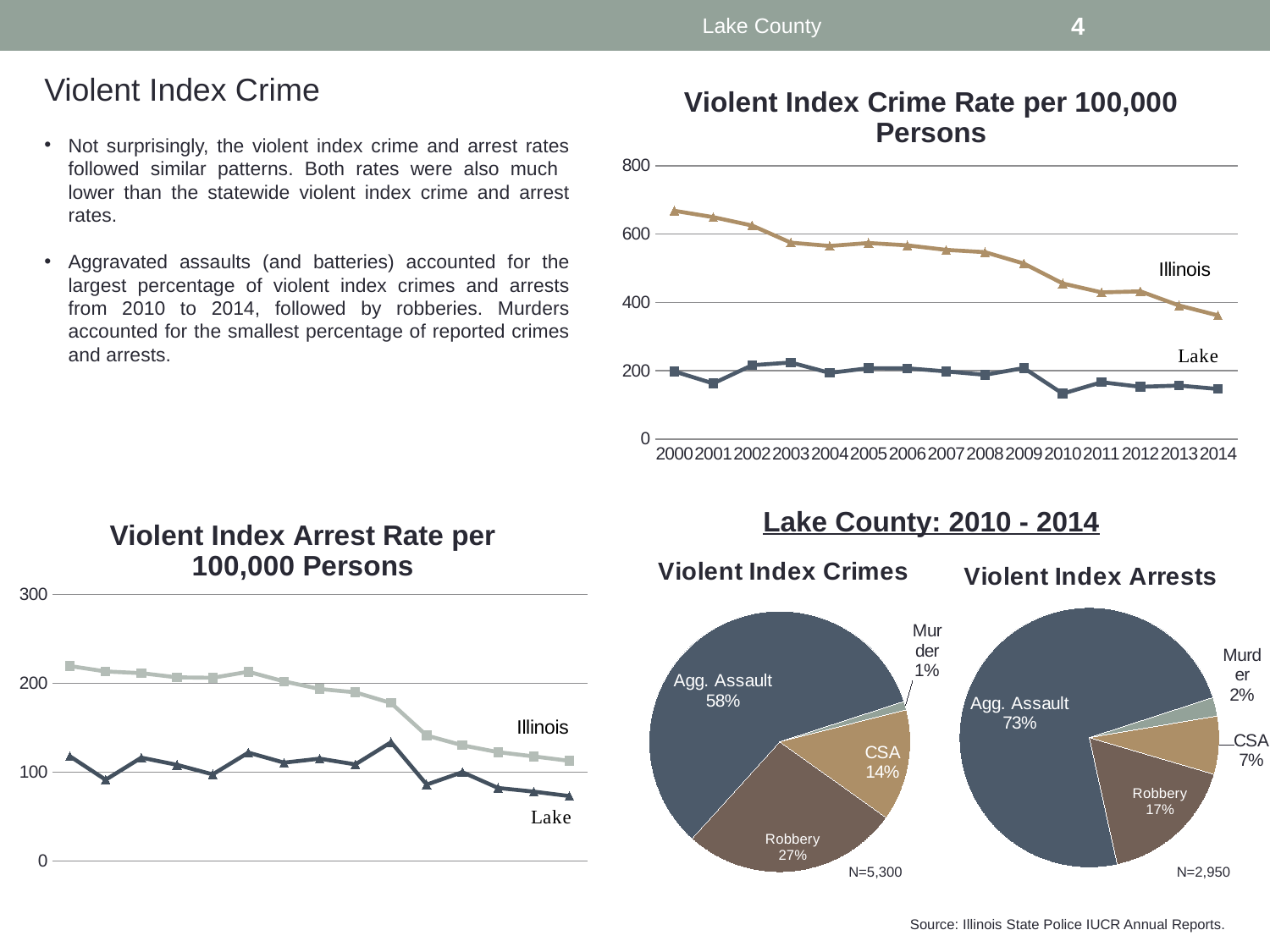
In the 'Violent Index Crime Rate per 100,000 Persons' chart, how many years are shown on the x axis? 15 In the 'Violent Index Crime Rate per 100,000 Persons' chart, is the Illinois value for 2014 greater or less than 400? less In the 'Violent Index Crime Rate per 100,000 Persons' chart, is the Illinois value for 2000 greater or less than 600? greater In the 'Violent Index Arrests' pie chart, which category has the smallest slice? Murder In the 'Violent Index Arrest Rate per 100,000 Persons' chart, is the last Lake value greater or less than 100? less In the 'Violent Index Crime Rate per 100,000 Persons' chart, does the Illinois rate generally rise or fall from 2000 to 2014? Fall In the 'Violent Index Arrests' pie chart, what share is Robbery? 17% How many percentage points higher is the Agg. Assault share in the 'Violent Index Arrests' pie than in the 'Violent Index Crimes' pie? 15 In the 'Violent Index Crimes' pie chart, what share is Agg. Assault? 58% What is the N shown for the 'Violent Index Crimes' pie chart? N=5,300 In the 'Violent Index Crime Rate per 100,000 Persons' chart, how many series are plotted? 2 What kind of chart is the 'Violent Index Crime Rate per 100,000 Persons' chart? Line chart